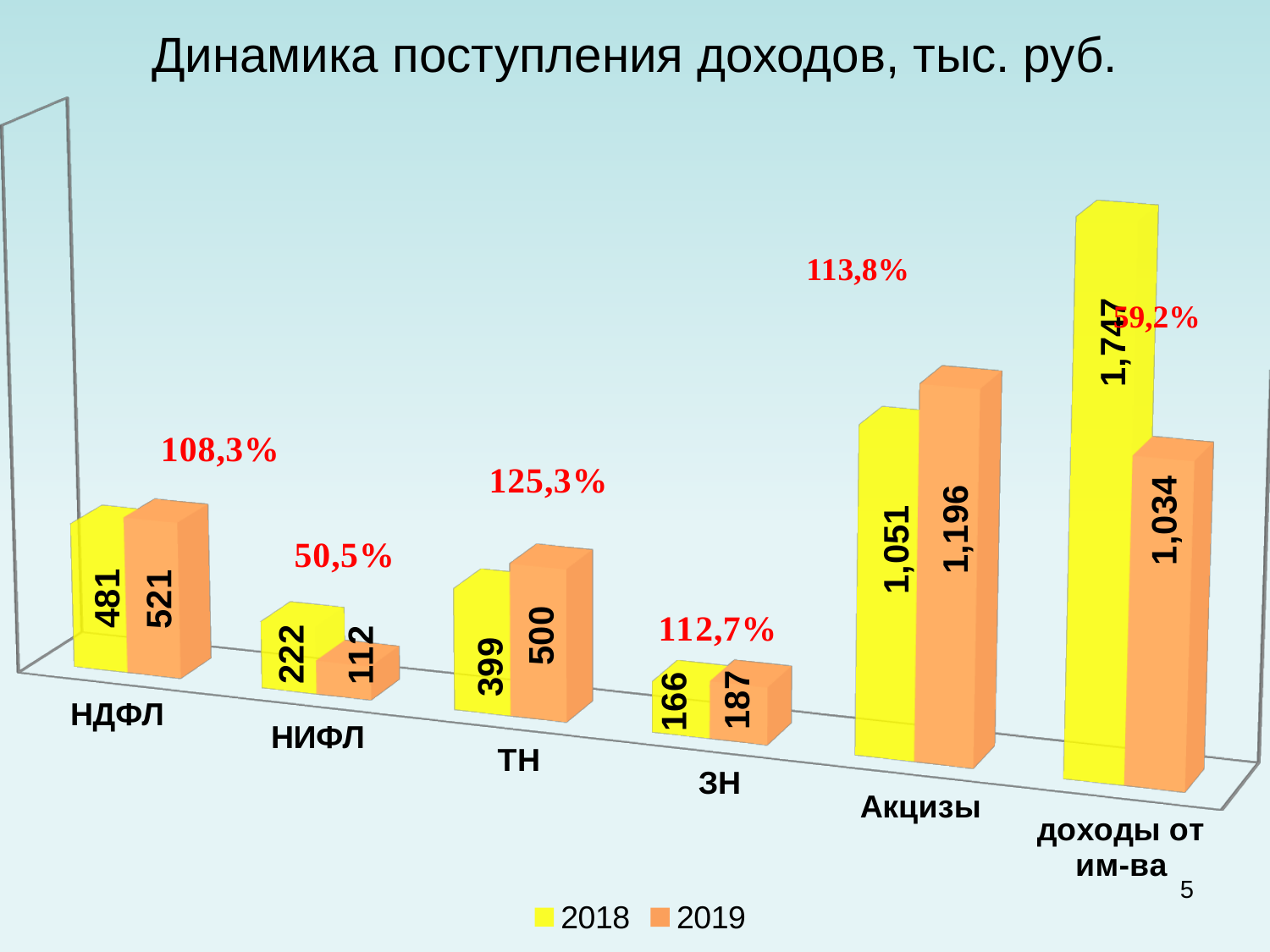
What is the title of the chart? Динамика поступления доходов, тыс. руб. How many categories are shown on the x axis? 6 What is the difference between the 2019 and 2018 values for ТН? 101 What is the value for НИФЛ in the 2018 series? 222 How many series does the legend list? 2 What is the value for НДФЛ in the 2019 series? 521 Which is larger for ЗН, the 2018 value or the 2019 value? 2019 What is the value for доходы от им-ва in the 2018 series? 1,747 What is the value for Акцизы in the 2019 series? 1,196 What kind of chart is shown on the slide? bar chart Which category has the highest value in the 2018 series? доходы от им-ва Which category has the lowest value in the 2019 series? НИФЛ